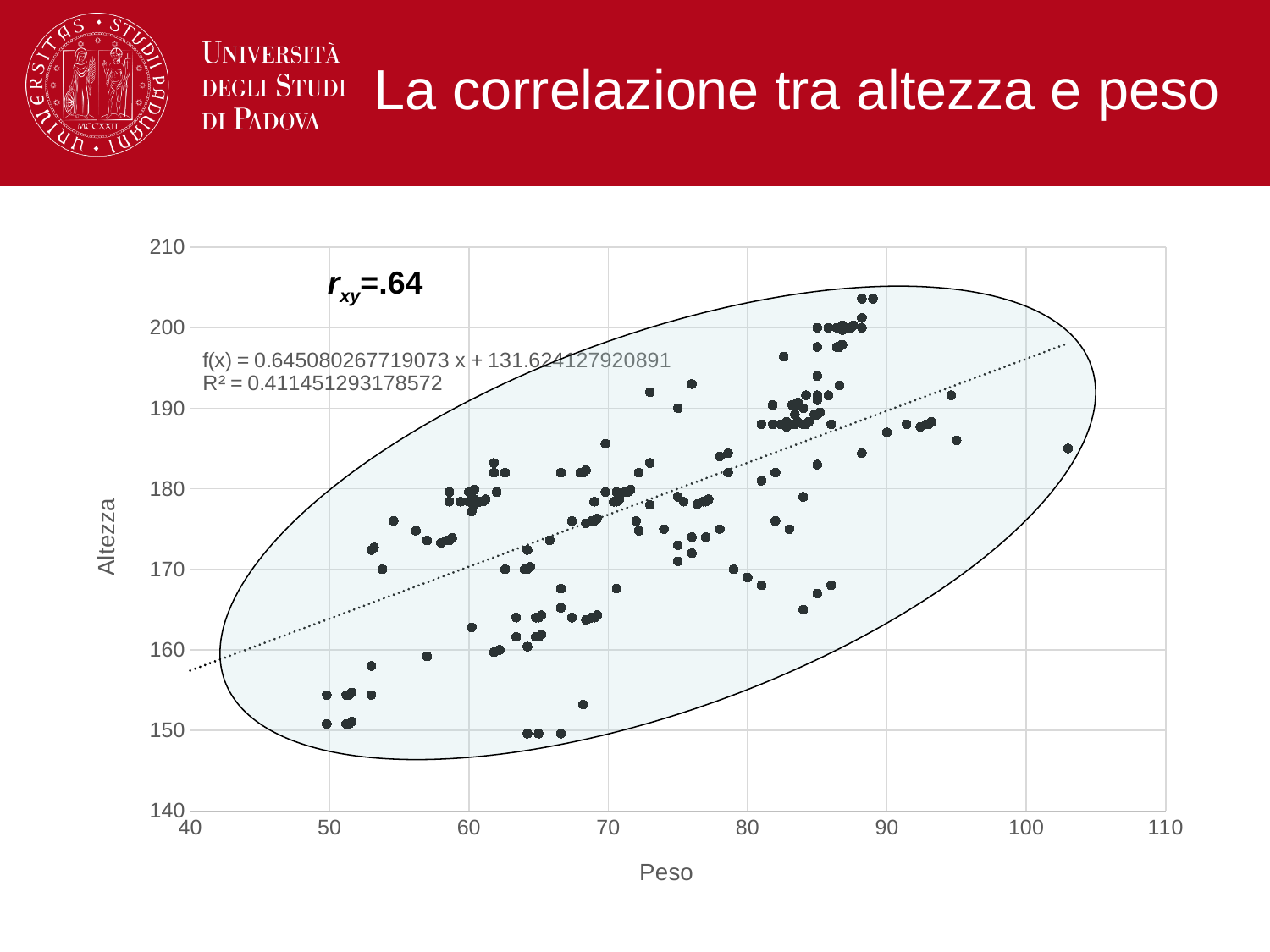
What is the label of the horizontal axis of the chart? Peso What is the intercept of the fitted line f(x) shown on the chart? 131.624127920891 Is the Altezza of the rightmost point on the chart greater or less than 180? greater What is the slope of the fitted line f(x) shown on the chart? 0.645080267719073 What is the R² value shown on the chart? 0.411451293178572 What is the label of the vertical axis of the chart? Altezza As Peso increases along the x axis, does Altezza tend to rise or fall? rise What kind of chart is shown on the slide? scatter chart Is the Peso of the rightmost point on the chart greater or less than 100? greater Is the Altezza of the highest point on the chart greater or less than 200? greater What is the value of the correlation coefficient r_xy shown on the chart? .64